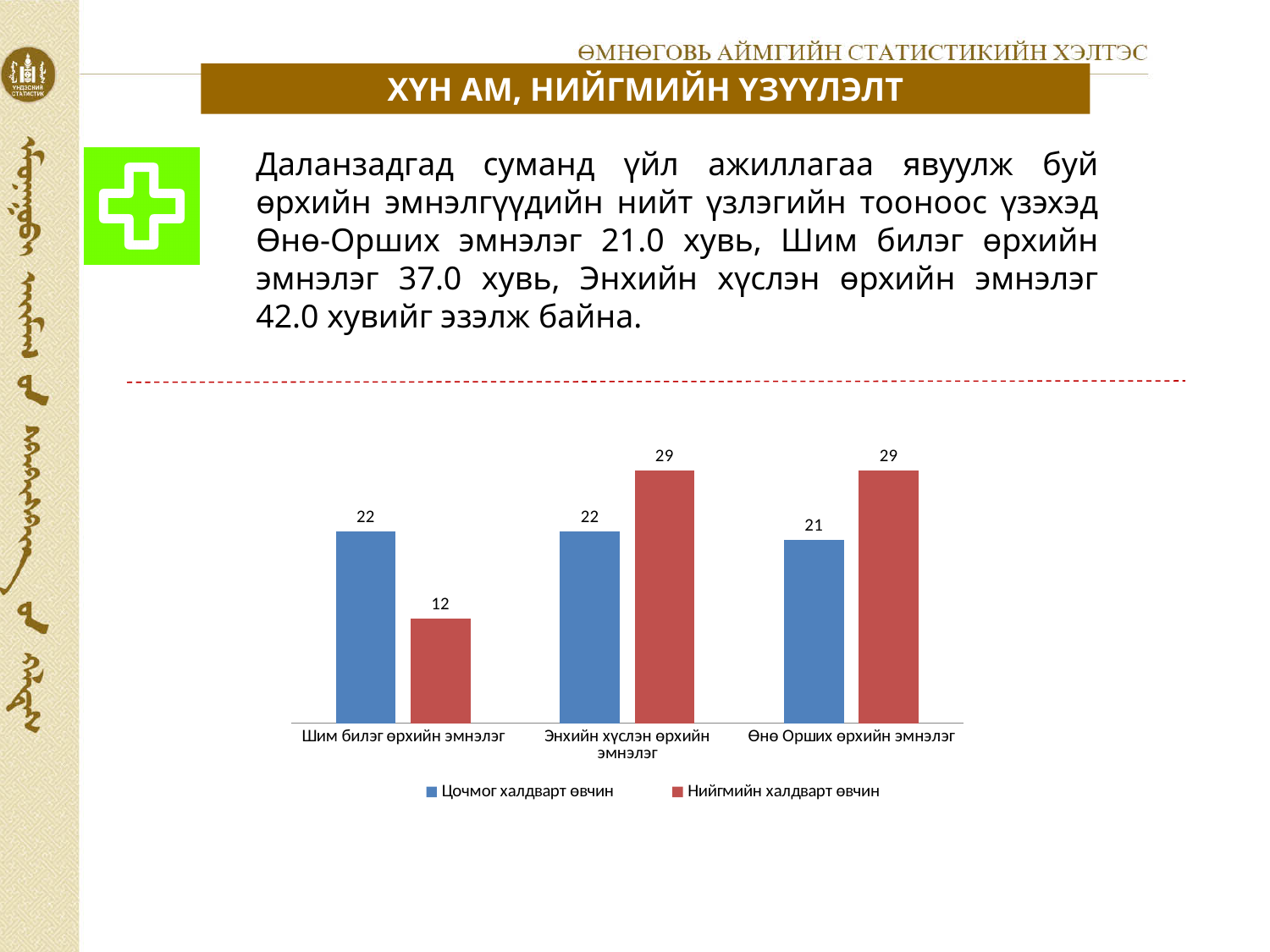
How many categories are shown on the x axis of the chart? 3 What is the difference between Цочмог халдварт өвчин and Нийгмийн халдварт өвчин for Шим билэг өрхийн эмнэлэг? 10 What is the value of Цочмог халдварт өвчин for Шим билэг өрхийн эмнэлэг? 22 What kind of chart is shown on the slide? Bar chart What is the value of Цочмог халдварт өвчин for Өнө Орших өрхийн эмнэлэг? 21 What is the value of Нийгмийн халдварт өвчин for Энхийн хүслэн өрхийн эмнэлэг? 29 How many series does the legend list? 2 Which category has the lowest value for Цочмог халдварт өвчин? Өнө Орших өрхийн эмнэлэг Which category has the lowest value for Нийгмийн халдварт өвчин? Шим билэг өрхийн эмнэлэг For Энхийн хүслэн өрхийн эмнэлэг, which series has the larger value: Цочмог халдварт өвчин or Нийгмийн халдварт өвчин? Нийгмийн халдварт өвчин What is the difference between Нийгмийн халдварт өвчин and Цочмог халдварт өвчин for Өнө Орших өрхийн эмнэлэг? 8 What is the value of Нийгмийн халдварт өвчин for Шим билэг өрхийн эмнэлэг? 12